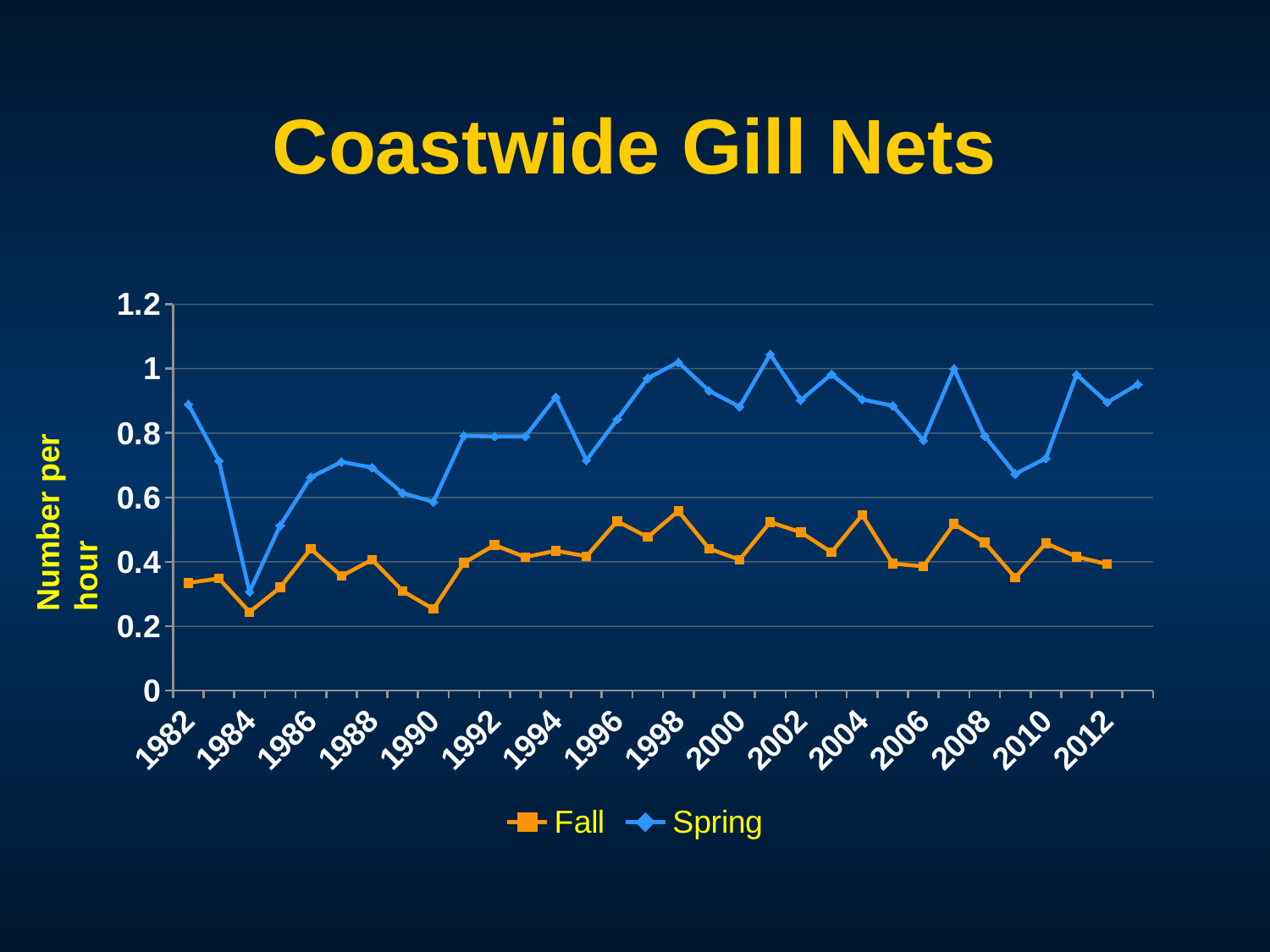
Is the Spring value for 2009 greater or less than 0.8? less Is the Fall value for 1990 greater or less than 0.4? less In which year is the Spring series at its lowest? 1984 Is the Fall value for 1998 greater or less than 0.6? less Does the Spring series rise or fall from 1982 to 1984? fall In 1982, which series has the higher value, Fall or Spring? Spring What is the label on the y axis? Number per hour How many series does the legend list? 2 What is the title of the chart? Coastwide Gill Nets What kind of chart is shown on the slide? line chart